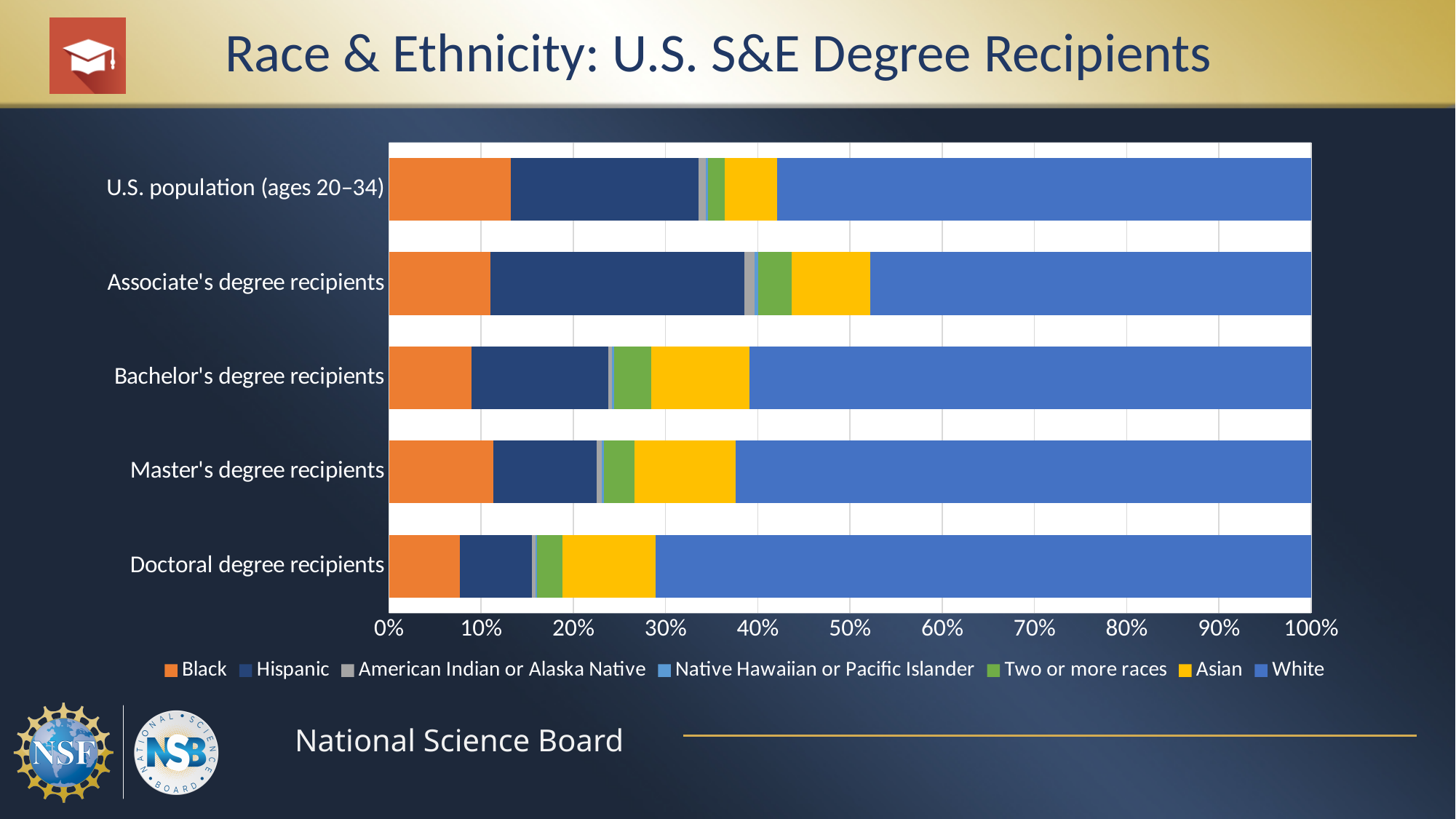
Which category has the largest Hispanic segment? Associate's degree recipients Which colour represents the Asian series in the chart? Yellow What kind of chart is shown on the slide? Stacked bar chart Which is larger: the Hispanic share for Associate's degree recipients or the Hispanic share for Doctoral degree recipients? Associate's degree recipients Which category has the smallest Black segment? Doctoral degree recipients How many categories (bars) are plotted on the chart? 5 What is the title of the slide containing the chart? Race & Ethnicity: U.S. S&E Degree Recipients How many series does the legend list? 7 Which category has the largest White segment? Doctoral degree recipients Is the Black share for Doctoral degree recipients greater or less than 10%? less Is the Black share for U.S. population (ages 20–34) greater or less than 10%? greater Is the White share for Associate's degree recipients greater or less than 50%? less